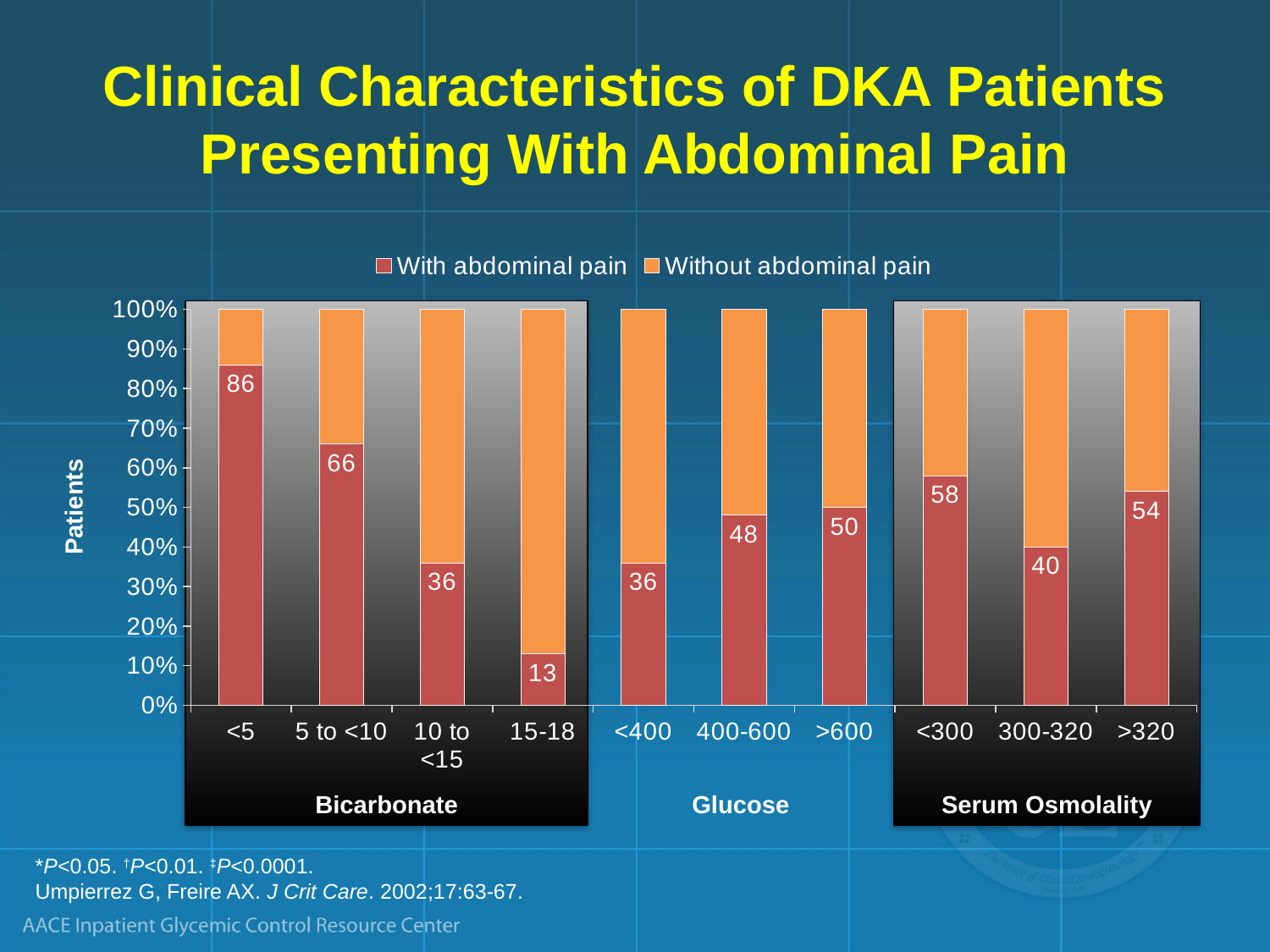
What kind of chart is shown on the slide? Stacked bar chart Is the 'With abdominal pain' value for Glucose <400 greater or less than 40%? less What is the value for 'With abdominal pain' in the Bicarbonate <5 category? 86 What is the value for 'With abdominal pain' in the Serum Osmolality 300-320 category? 40 What is the difference between the 'With abdominal pain' values for Bicarbonate <5 and Bicarbonate 5 to <10? 20 Which category has the lowest 'With abdominal pain' value? 15-18 (Bicarbonate) What is the value for 'With abdominal pain' in the Bicarbonate 15-18 category? 13 Which category has the highest 'With abdominal pain' value? <5 (Bicarbonate) How many series does the legend list? 2 What is the value for 'With abdominal pain' in the Glucose 400-600 category? 48 Which has the larger 'With abdominal pain' value: Serum Osmolality <300 or Serum Osmolality >320? <300 How many categories are shown on the x axis in total? 10